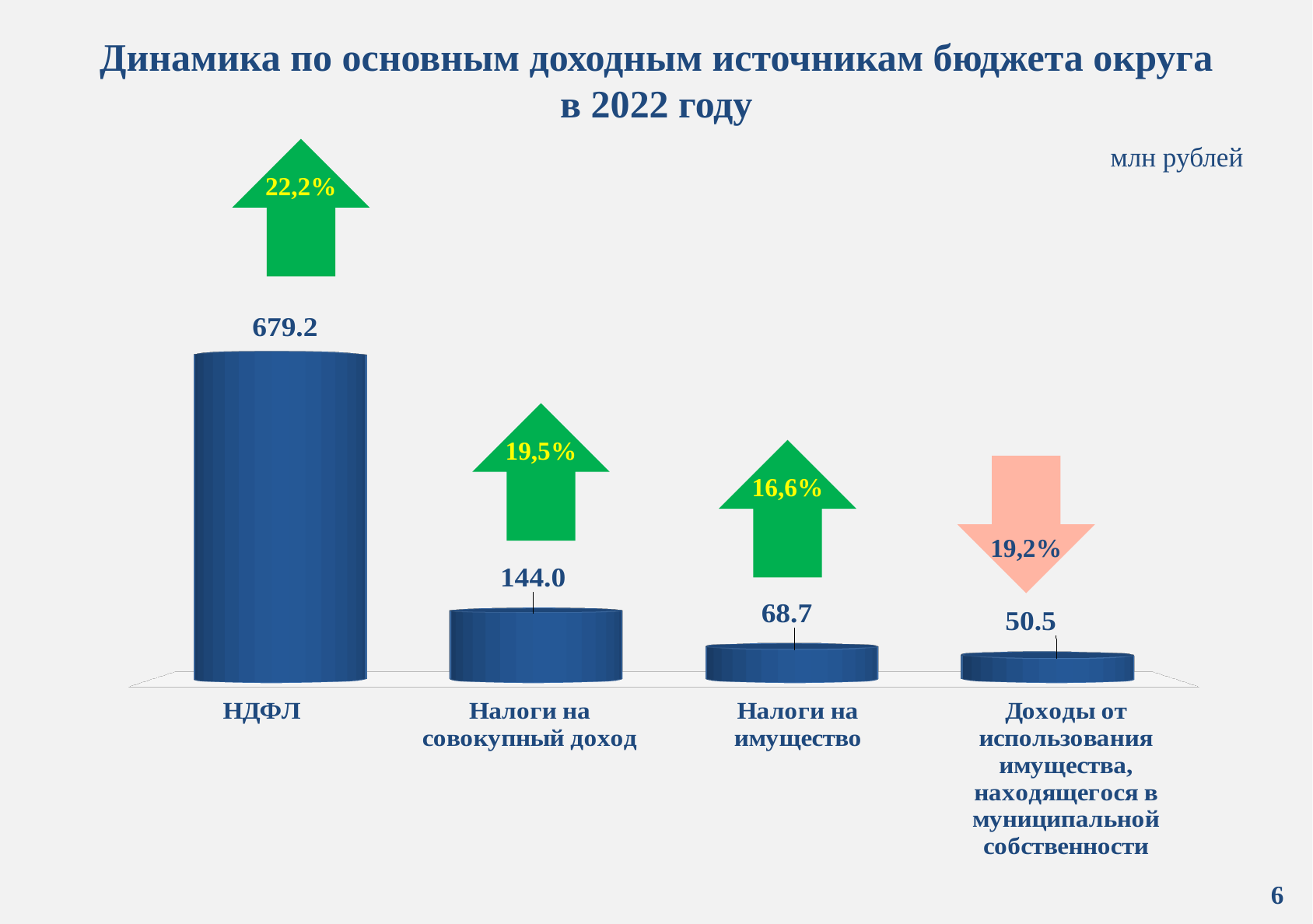
What is the value for НДФЛ? 679.2 What is the value for Доходы от использования имущества, находящегося в муниципальной собственности? 50.5 What percentage change is shown above the НДФЛ bar? 22,2% Which category has the highest value? НДФЛ What is the value for Налоги на имущество? 68.7 How many categories are shown in the chart? 4 What is the difference between the values for Налоги на имущество and Доходы от использования имущества, находящегося в муниципальной собственности? 18.2 What is the value for Налоги на совокупный доход? 144.0 What is the difference between the values for НДФЛ and Налоги на совокупный доход? 535.2 Which is larger, the value for Налоги на совокупный доход or the value for Налоги на имущество? Налоги на совокупный доход What kind of chart is shown on the slide? bar chart Which category has the lowest value? Доходы от использования имущества, находящегося в муниципальной собственности